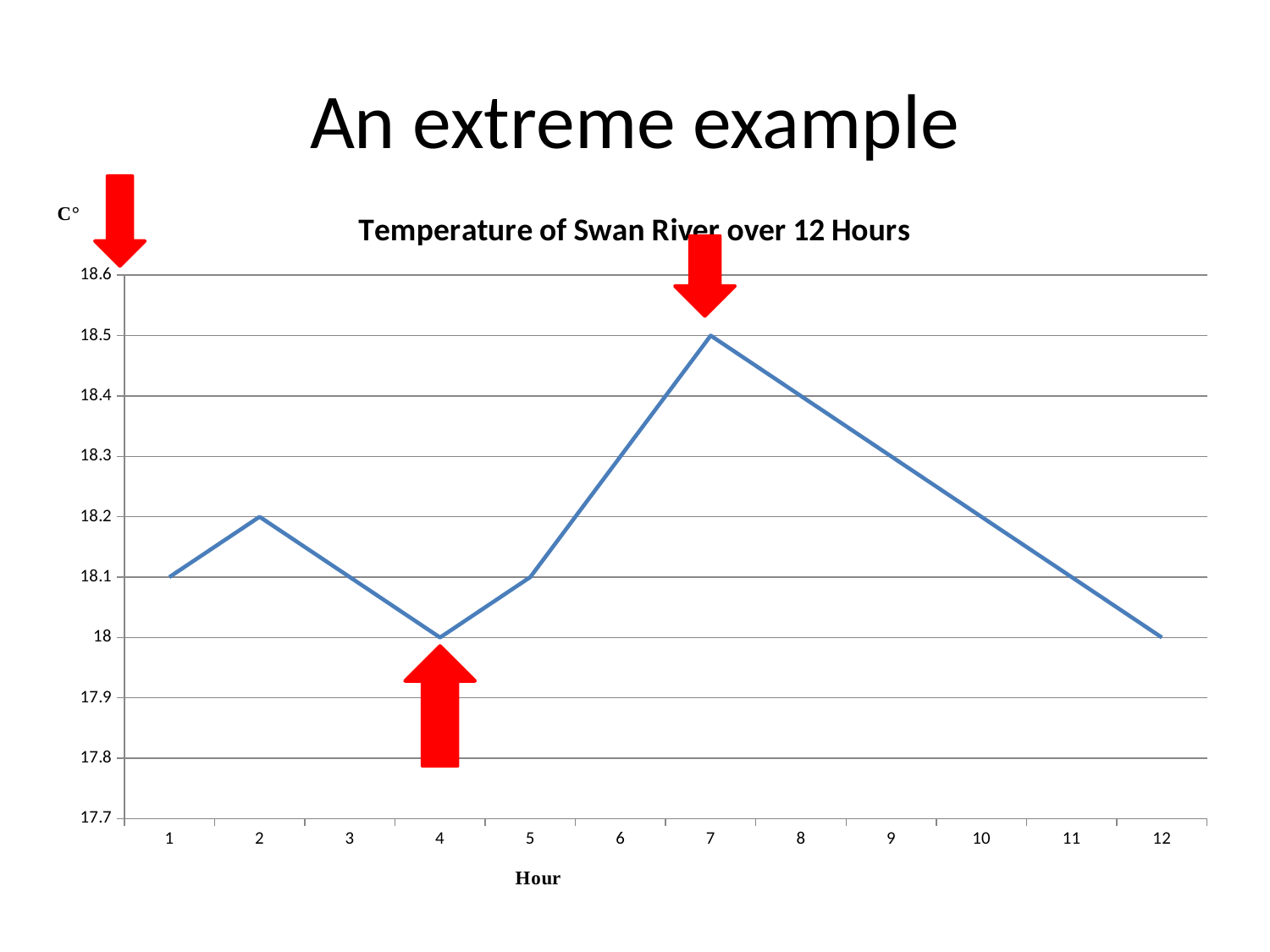
What is the temperature at hour 4? 18 How many hours are shown on the x axis? 12 What is the temperature at hour 2? 18.2 At which hour is the temperature highest? 7 Does the temperature rise or fall from hour 7 to hour 12? fall What is the difference between the temperature at hour 7 and the temperature at hour 4? 0.5 What is the temperature at hour 1? 18.1 What is the temperature at hour 7? 18.5 What is the label of the x axis? Hour What kind of chart is shown on the slide? line chart Which is higher, the temperature at hour 2 or at hour 5? hour 2 What is the title of the chart? Temperature of Swan River over 12 Hours